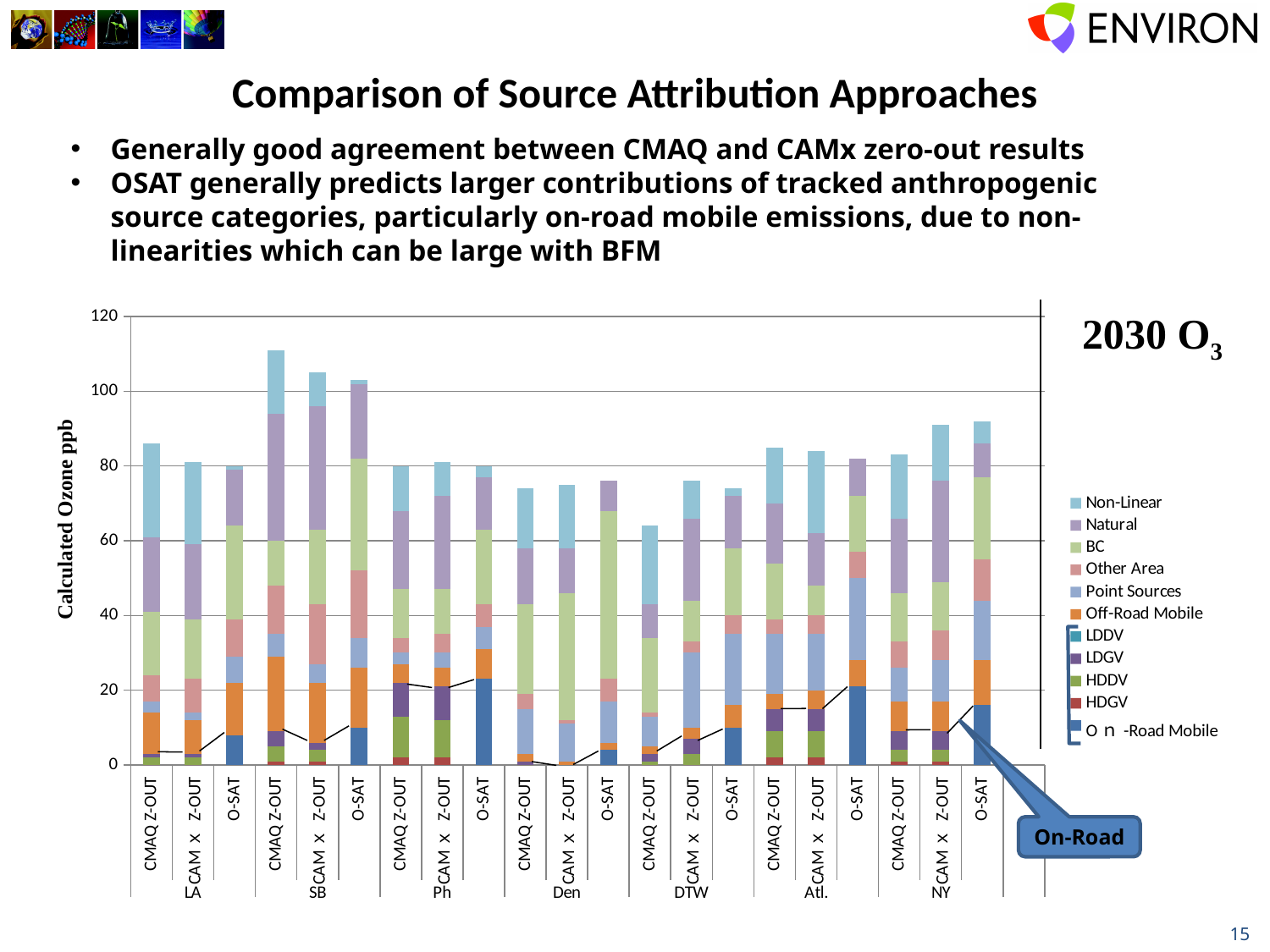
Which bar has a larger total: the NY O-SAT bar or the Atl. O-SAT bar? NY O-SAT What kind of chart is shown on the slide? stacked bar chart How many city groups are shown along the x axis of the chart? 7 Is the total for the SB CMAQ Z-OUT bar greater or less than 100? greater Which bar in the chart has the highest total calculated ozone? CMAQ Z-OUT for SB Which bar in the chart has the lowest total calculated ozone? CMAQ Z-OUT for DTW How many bars are plotted in the chart in total? 21 Is the total for the DTW CMAQ Z-OUT bar greater or less than 80? less Is the total for the LA CMAQ Z-OUT bar greater or less than 80? greater Which legend entry is the topmost segment of each stacked bar in the chart? Non-Linear How many series does the chart legend list? 11 What is the label on the vertical axis of the chart? Calculated Ozone ppb